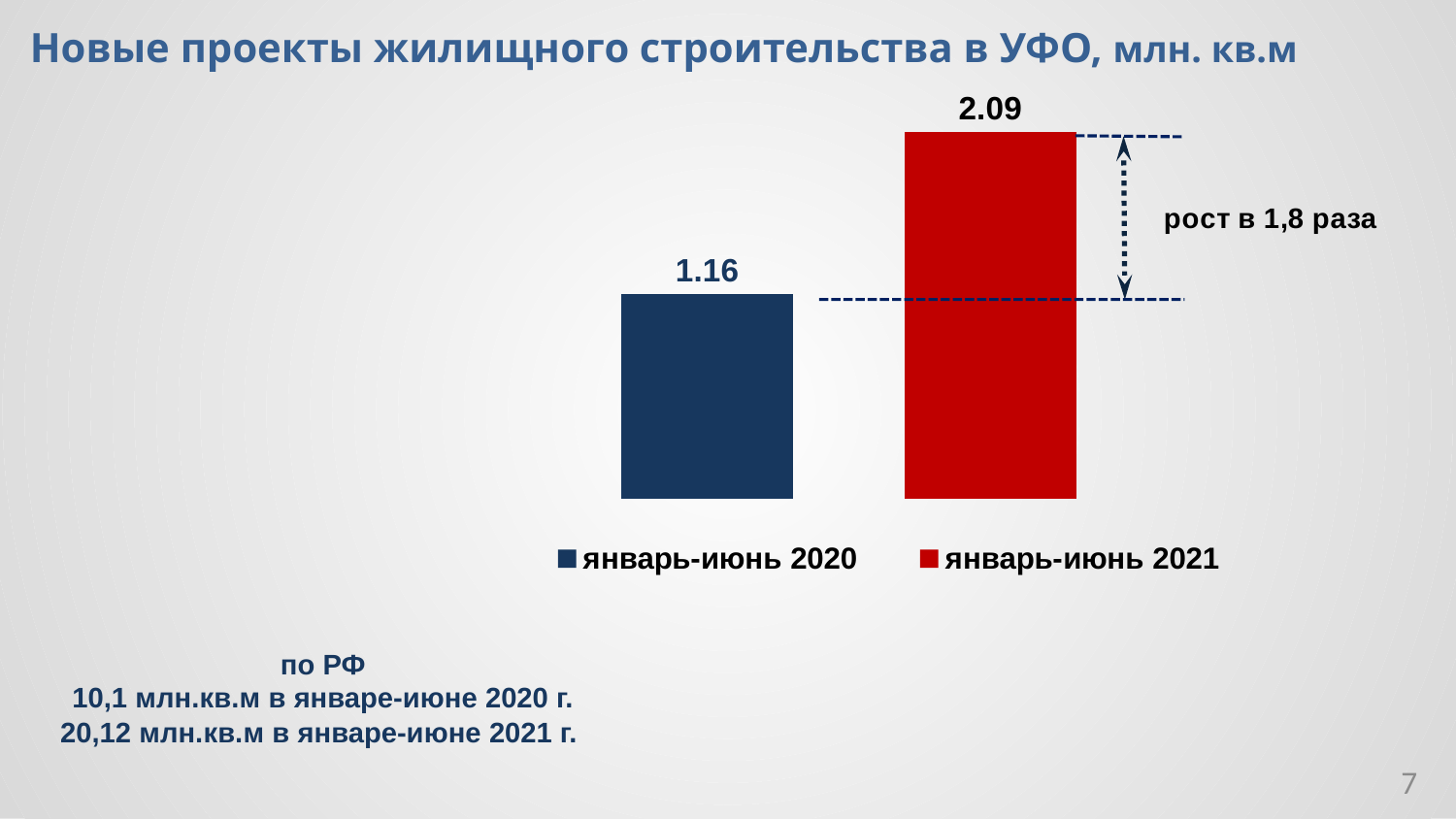
What is the difference between the values for январь-июнь 2021 and январь-июнь 2020? 0.93 Which period has the higher value, январь-июнь 2020 or январь-июнь 2021? январь-июнь 2021 What kind of chart is shown on the slide? bar chart What growth factor is annotated between the two bars? рост в 1,8 раза Do the values rise or fall from январь-июнь 2020 to январь-июнь 2021? rise Which period has the lowest value on the chart? январь-июнь 2020 What is the value for январь-июнь 2021? 2.09 Is the value for январь-июнь 2021 larger or smaller than the value for январь-июнь 2020? larger What is the title of the chart? Новые проекты жилищного строительства в УФО, млн. кв.м What is the value for январь-июнь 2020? 1.16 How many series does the legend list? 2 How many bars are plotted on the chart? 2